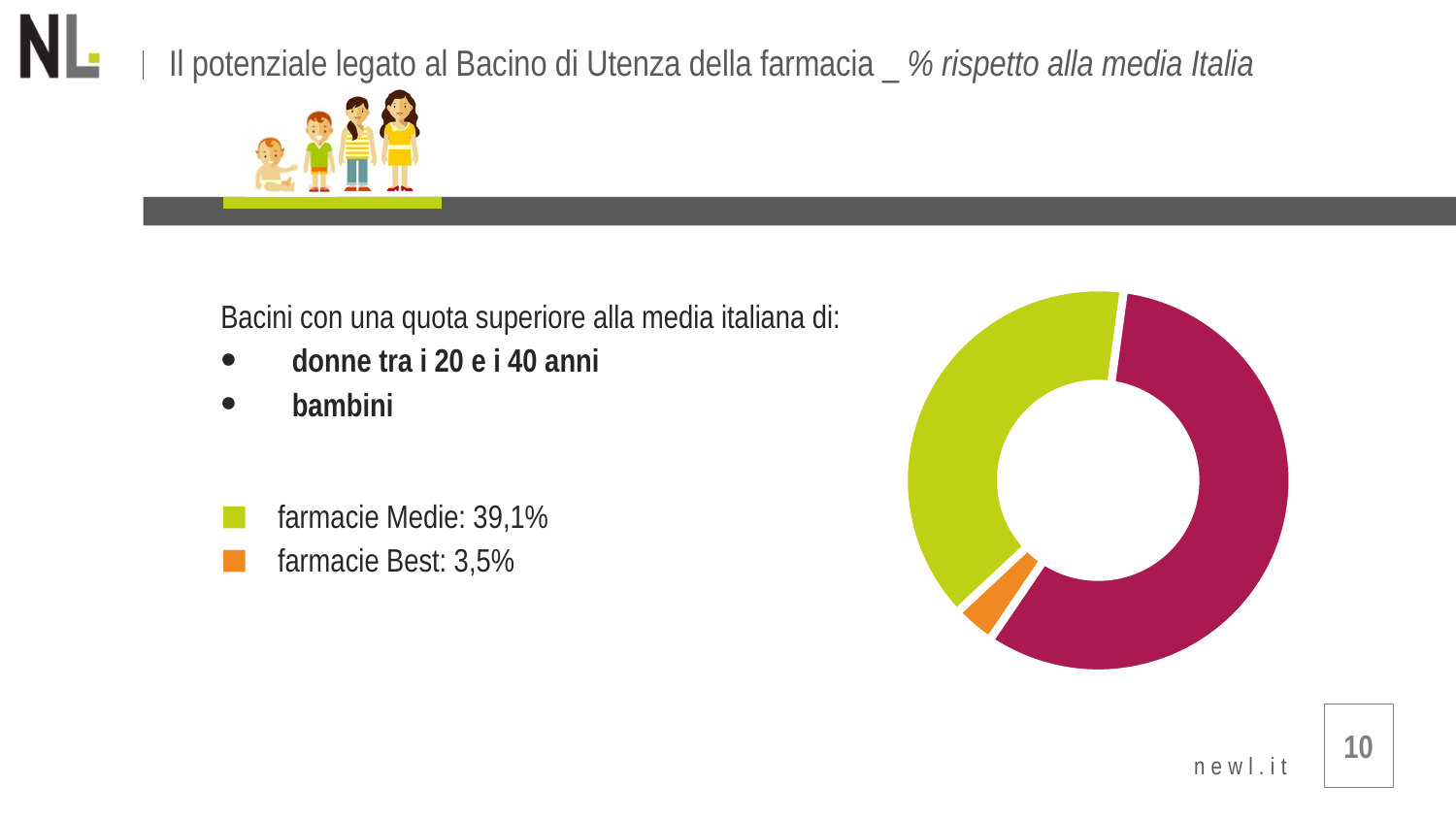
What is the difference between the farmacie Medie share and the farmacie Best share? 35,6% What colour represents farmacie Best in the chart? Orange How many slices does the donut chart have? 3 What is the value shown for farmacie Best? 3,5% What type of chart is shown on the slide? Donut (pie) chart Which of the labelled categories has the smallest slice in the donut chart? farmacie Best What is the value shown for farmacie Medie? 39,1% What colour represents farmacie Medie in the chart? Green How many entries does the legend list? 2 Is the magenta slice larger or smaller than the green slice? Larger Which has the larger share, farmacie Medie or farmacie Best? farmacie Medie